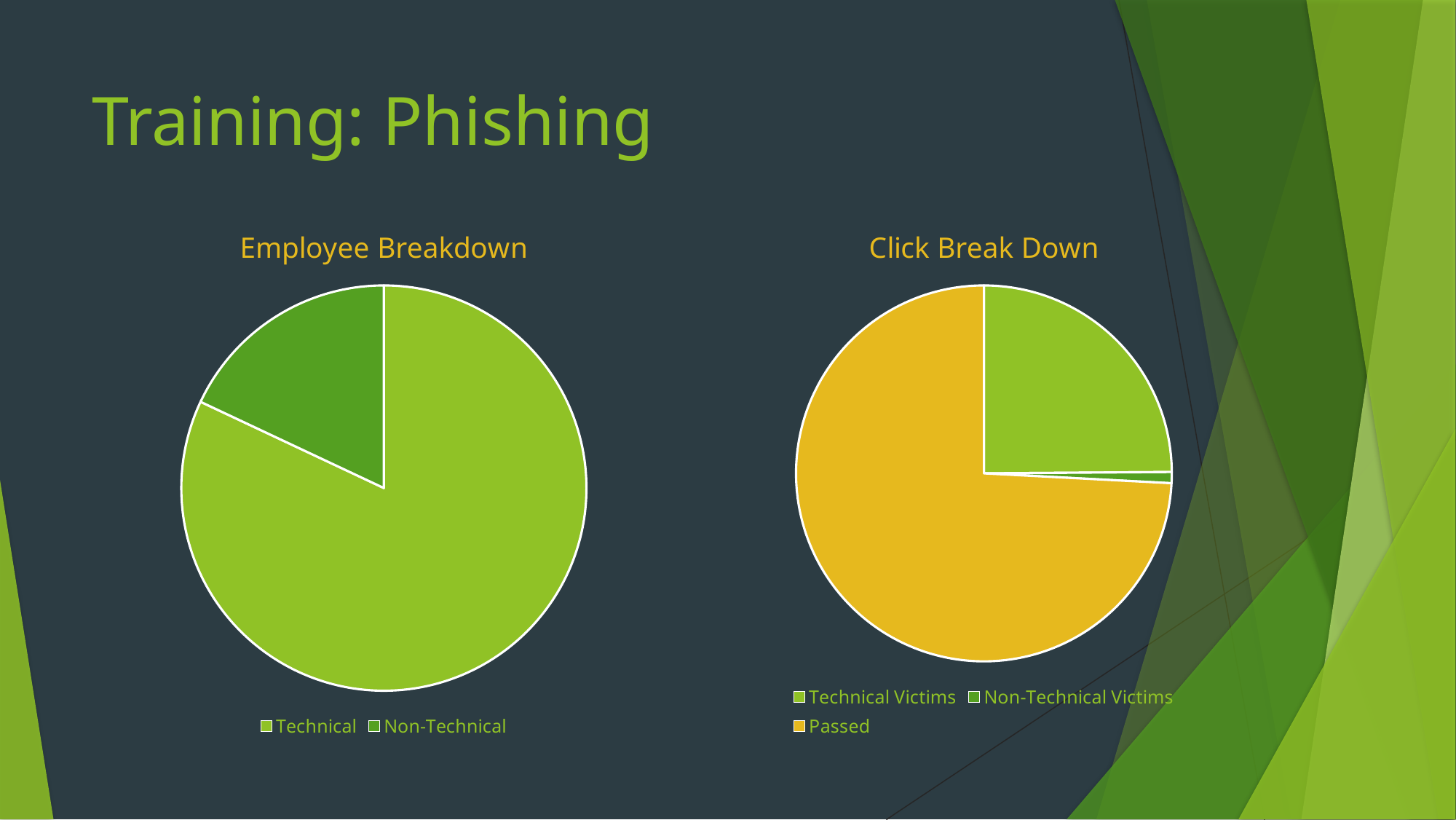
In the "Click Break Down" chart, which category has the smallest slice? Non-Technical Victims In the "Click Break Down" chart, which slice is larger: Technical Victims or Non-Technical Victims? Technical Victims In the "Employee Breakdown" chart, which category has the smallest slice? Non-Technical In the "Click Break Down" chart, how many categories does the legend list? 3 In the "Employee Breakdown" chart, how many slices does the pie have? 2 What is the title of the pie chart on the right side of the slide? Click Break Down In the "Click Break Down" chart, which category has the largest slice? Passed In the "Employee Breakdown" chart, which slice is larger: Technical or Non-Technical? Technical In the "Employee Breakdown" chart, which category has the largest slice? Technical What kind of chart is the "Click Break Down" chart? pie chart In the "Click Break Down" chart, what colour is the Passed slice? yellow What kind of chart is the "Employee Breakdown" chart? pie chart